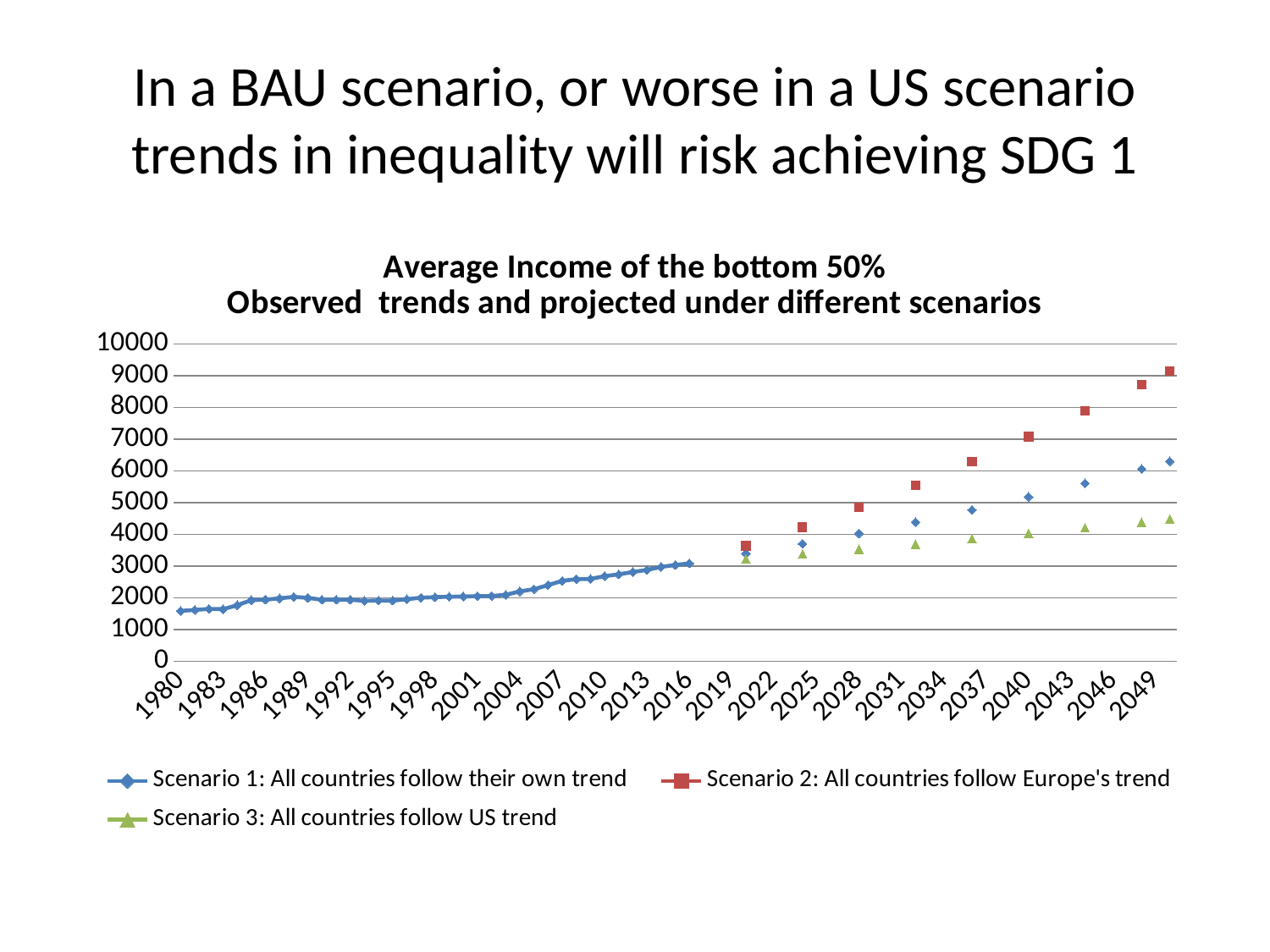
What is the title of the chart? Average Income of the bottom 50% Observed trends and projected under different scenarios What is the first year shown on the x axis? 1980 What kind of chart is shown on the slide? line chart Is the value for Scenario 1 in 1980 greater or less than 2000? less How many series does the legend list? 3 Which series is plotted with red square markers? Scenario 2: All countries follow Europe's trend Do the values for Scenario 2 rise or fall from 2019 to 2049? rise Which scenario has the highest value at the end of the projection period (around 2049)? Scenario 2: All countries follow Europe's trend Which scenario has the lowest value at the end of the projection period (around 2049)? Scenario 3: All countries follow US trend In 2040, which is larger: the value for Scenario 1 or the value for Scenario 3? Scenario 1